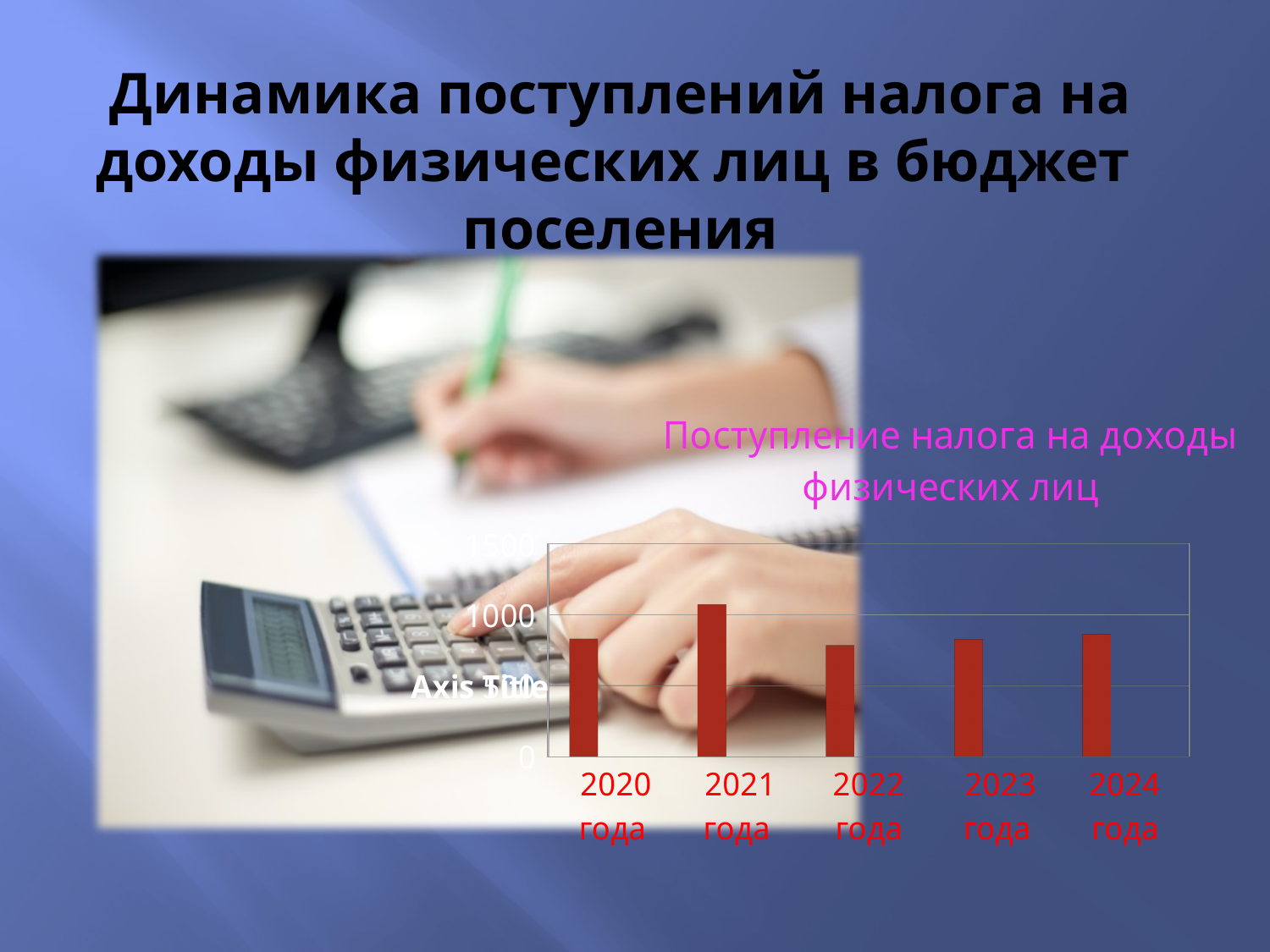
How many years are shown on the x axis of the chart? 5 Is the value for 2022 года greater or less than 500? greater What is the highest value shown on the chart's vertical axis? 1500 Which is larger, the value for 2024 года or the value for 2022 года? 2024 года Which year has the highest bar in the chart? 2021 года Which is larger, the value for 2021 года or the value for 2022 года? 2021 года Is the value for 2021 года greater or less than 1000? greater What type of chart is shown on the slide? bar chart Is the value for 2020 года greater or less than 1000? less What is the title of the chart? Поступление налога на доходы физических лиц